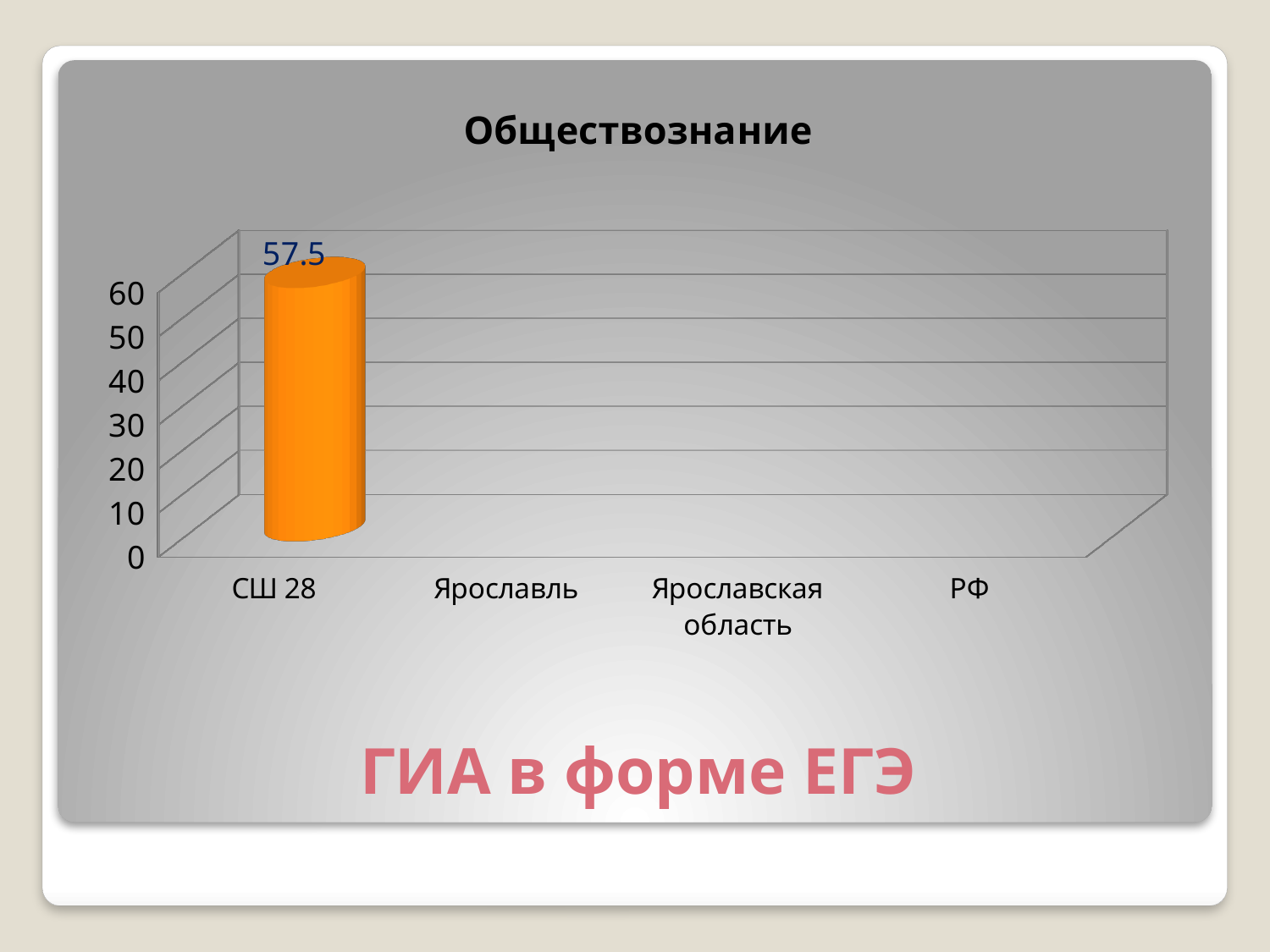
Is the value for СШ 28 greater or less than 50? greater What is the value shown for СШ 28 in the Обществознание chart? 57.5 Is the value for СШ 28 greater or less than 60? less What is the highest tick value shown on the vertical axis? 60 How many categories are listed along the x axis of the chart? 4 How many categories have a bar plotted in the chart? 1 What colour is the bar for СШ 28? orange What kind of chart is shown on the slide? bar chart Which category is listed last on the x axis? РФ Which category has the highest value in the chart? СШ 28 What is the title of the chart? Обществознание